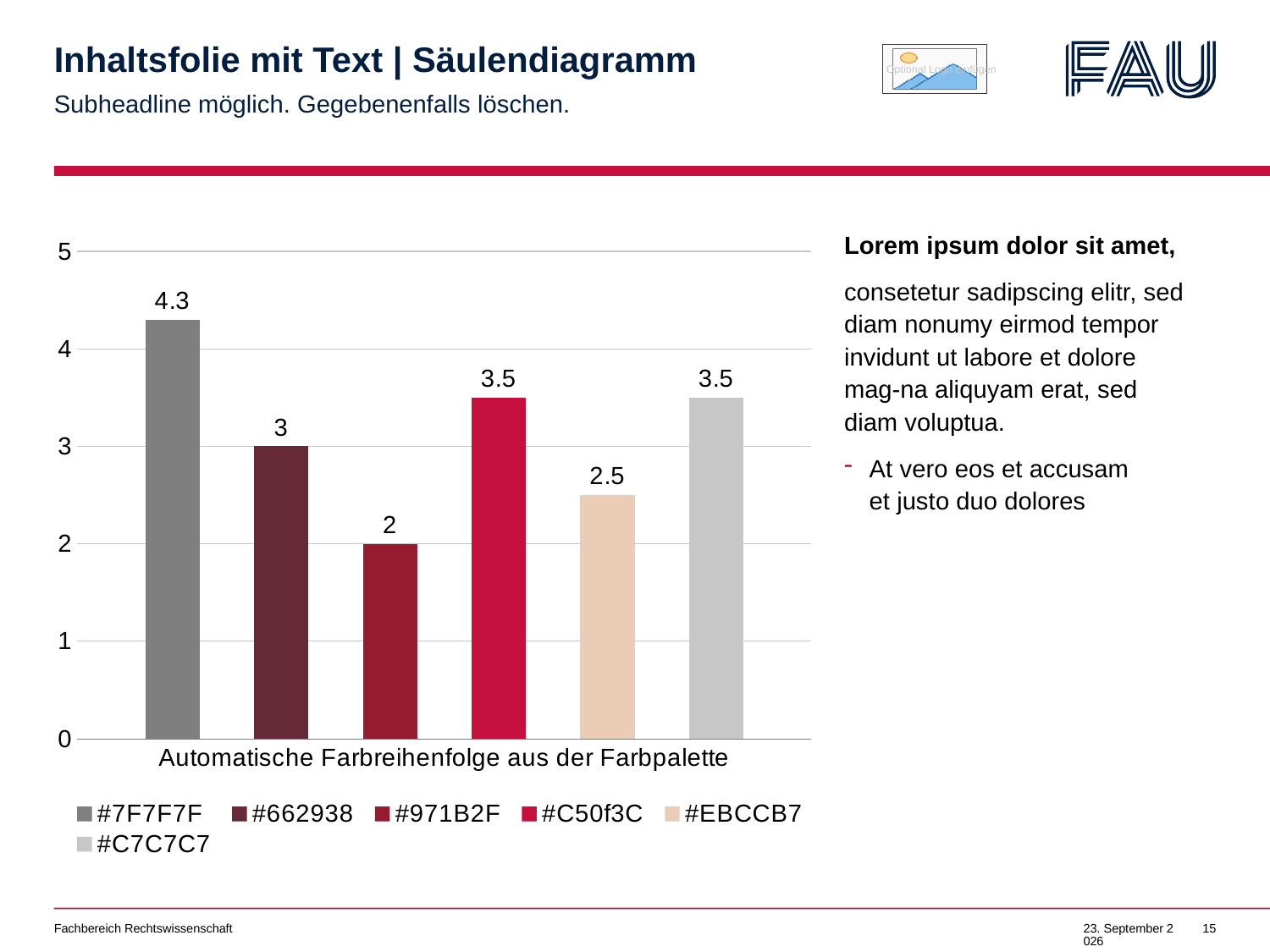
What is the difference between the values of the #7F7F7F series and the #971B2F series? 2.3 How many series does the legend list? 6 What is the value of the #C50f3C series? 3.5 Which series has the lowest value? #971B2F What is the value of the #EBCCB7 series? 2.5 What kind of chart is shown on the slide? bar chart Which is larger, the value of the #662938 series or the #EBCCB7 series? #662938 What is the category label shown on the x axis of the chart? Automatische Farbreihenfolge aus der Farbpalette What is the value of the #7F7F7F series? 4.3 What is the value of the #662938 series? 3 Is the value of the #C7C7C7 series greater or less than 3? greater Which series has the highest value? #7F7F7F